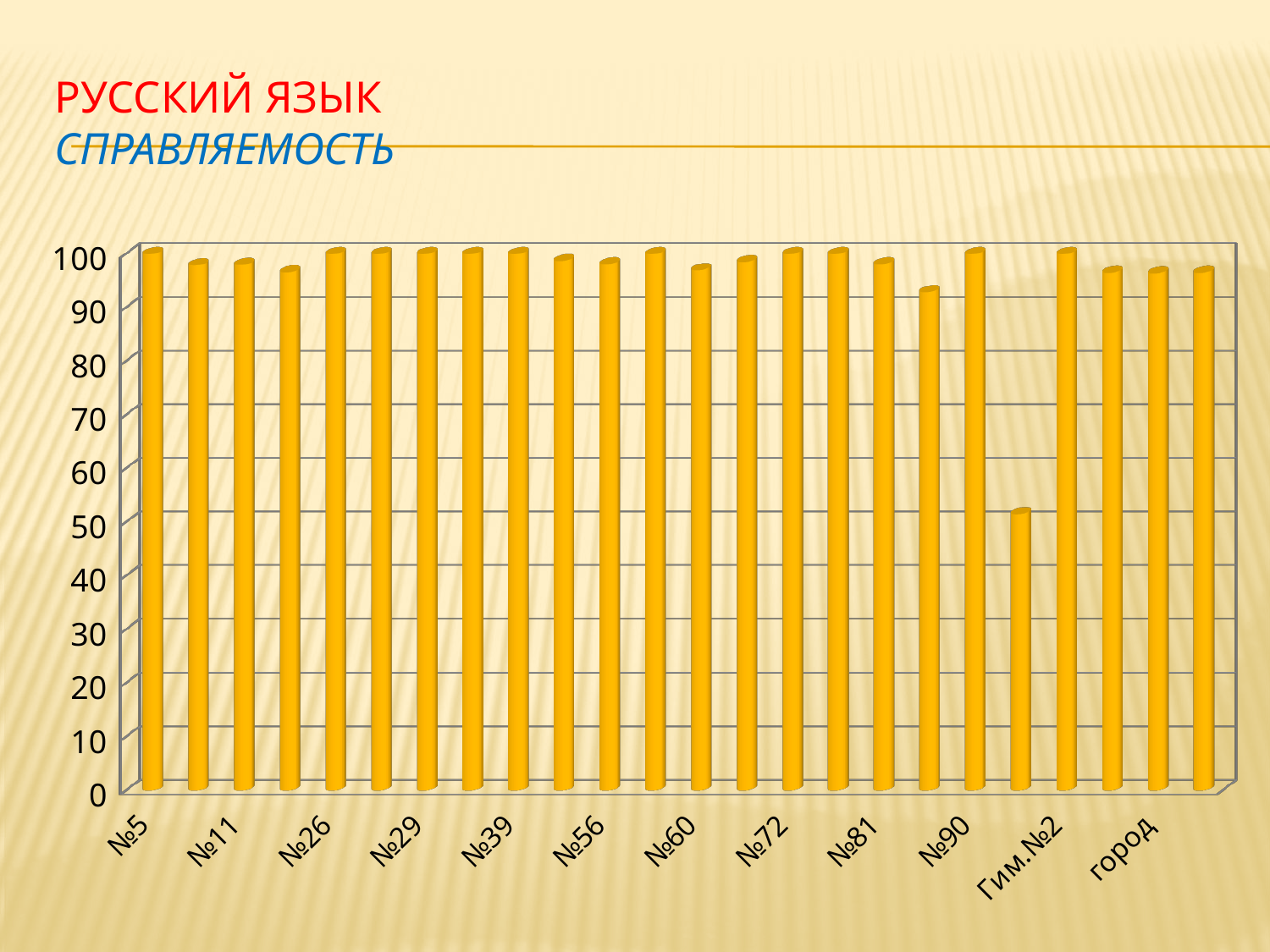
Is the value for №5 greater or less than 90? greater What is the highest value shown on the vertical axis? 100 Is the value for №90 greater or less than 80? greater Is the value for Гим.№2 greater or less than 90? greater Which has the larger value, №5 or №90? Neither; they are equal (both 100) What is the title of the slide containing the chart? Русский язык. Справляемость What kind of chart is shown on the slide? bar chart What colour are the bars in the chart? orange Which has the larger value, Гим.№2 or №90? Neither; they are equal (both 100)